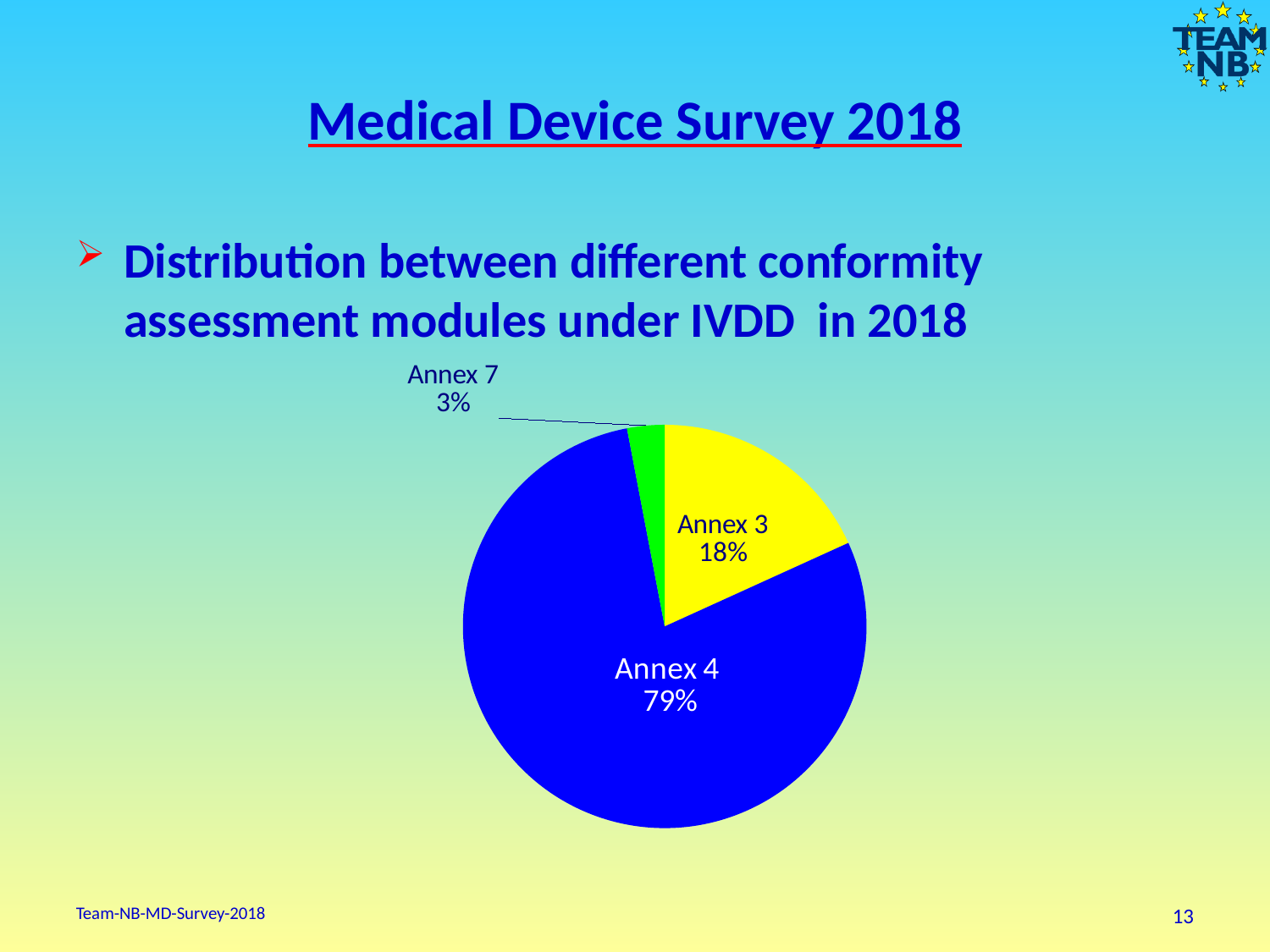
What is the difference in percentage points between Annex 3 and Annex 7? 15 What share of the pie does Annex 3 represent? 18% What colour is the Annex 4 slice? blue What is the difference in percentage points between Annex 4 and Annex 3? 61 What share of the pie does Annex 4 represent? 79% How many slices does the pie chart have? 3 What share of the pie does Annex 7 represent? 3% What kind of chart is shown on the slide? pie chart What colour is the Annex 7 slice? green Which is larger, the share for Annex 3 or the share for Annex 7? Annex 3 Which annex has the largest share of the pie? Annex 4 Which annex has the smallest share of the pie? Annex 7